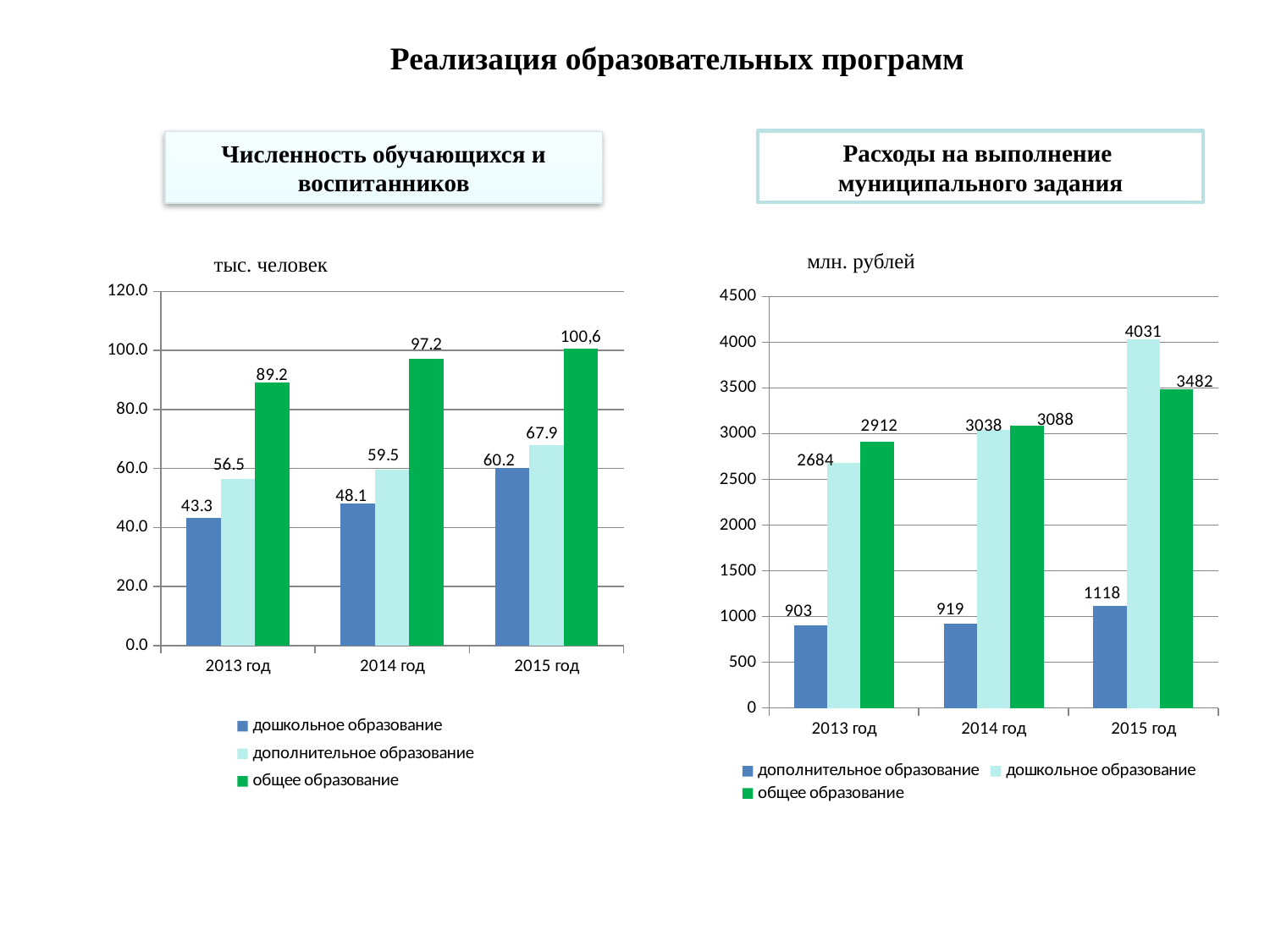
In the chart 'Численность обучающихся и воспитанников', which year has the highest value for дополнительное образование? 2015 год In the chart 'Расходы на выполнение муниципального задания', what is the value for дополнительное образование in 2014 год? 919 In the chart 'Расходы на выполнение муниципального задания', which series has the lowest value in 2013 год? дополнительное образование In the chart 'Численность обучающихся и воспитанников', what is the difference between общее образование in 2014 год and 2013 год? 8.0 In the chart 'Расходы на выполнение муниципального задания', what is the value for дошкольное образование in 2015 год? 4031 In the chart 'Численность обучающихся и воспитанников', what is the value for дошкольное образование in 2013 год? 43.3 In the chart 'Численность обучающихся и воспитанников', does the value for дошкольное образование rise or fall from 2013 год to 2015 год? rise In the chart 'Численность обучающихся и воспитанников', how many series does the legend list? 3 What kind of chart is 'Расходы на выполнение муниципального задания'? bar chart In the chart 'Численность обучающихся и воспитанников', what is the value for общее образование in 2015 год? 100,6 In the chart 'Расходы на выполнение муниципального задания', what is the difference between общее образование in 2015 год and 2014 год? 394 In the chart 'Расходы на выполнение муниципального задания', which is larger in 2015 год: дошкольное образование or общее образование? дошкольное образование